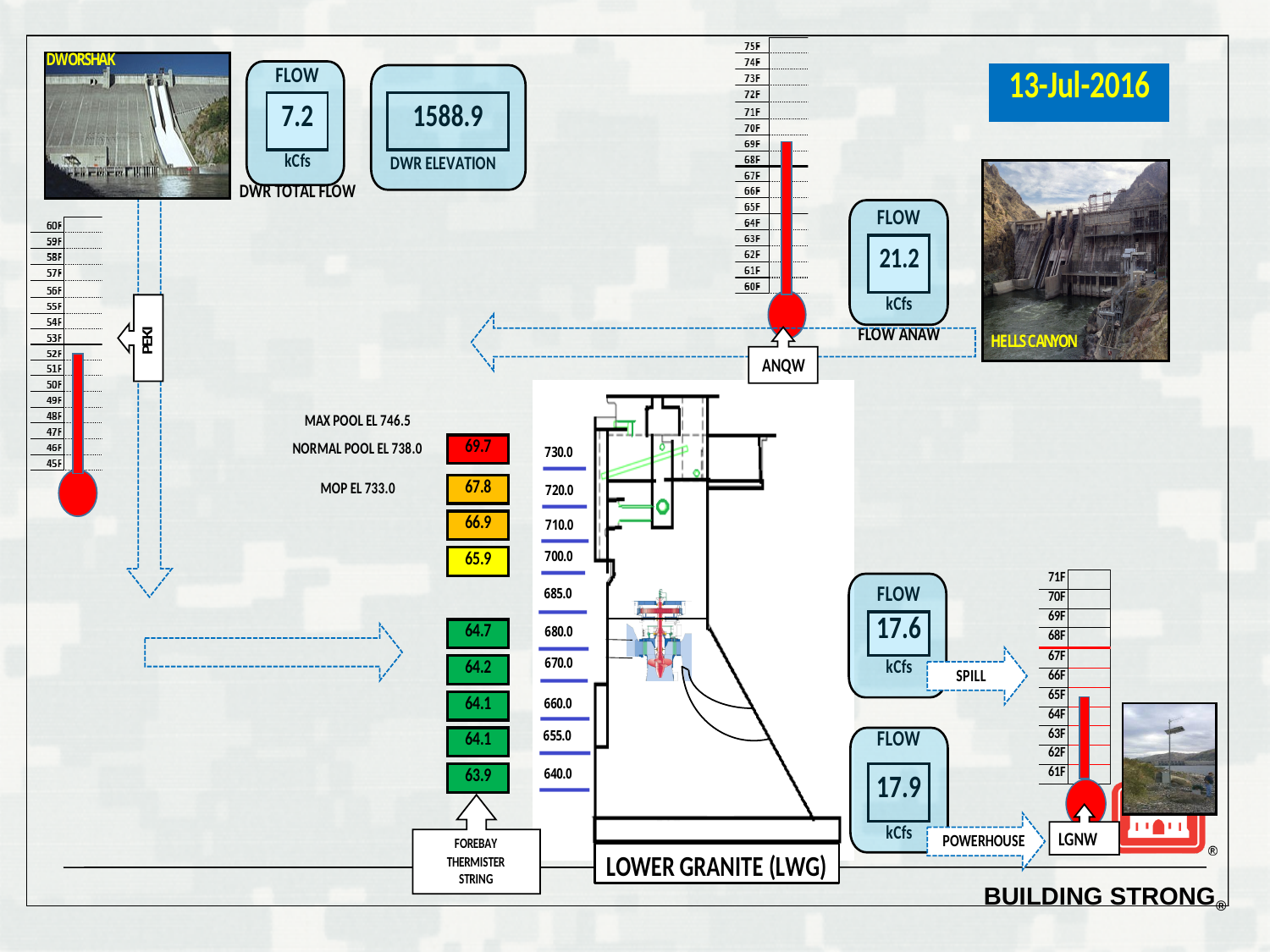
Do the forebay thermistor string readings increase or decrease from top to bottom? decrease What is the difference between the highest and lowest readings in the forebay thermistor string? 5.8 In the forebay thermistor string, what is the bottom-most temperature value? 63.9 What date is shown on the slide? 13-Jul-2016 What is the DWR elevation value shown on the slide? 1588.9 Which reading in the forebay thermistor string is the highest? 69.7 How many temperature readings are shown in the forebay thermistor string? 9 What is the DWR total flow value shown in the FLOW box next to the Dworshak photo? 7.2 kCfs In the forebay thermistor string, what is the topmost (red) temperature value? 69.7 Which is larger at Lower Granite, the SPILL flow or the POWERHOUSE flow? POWERHOUSE (17.9 kCfs) What is the Hells Canyon (FLOW ANAW) flow value? 21.2 kCfs Is the PEKI thermometer reading greater or less than 55F? less